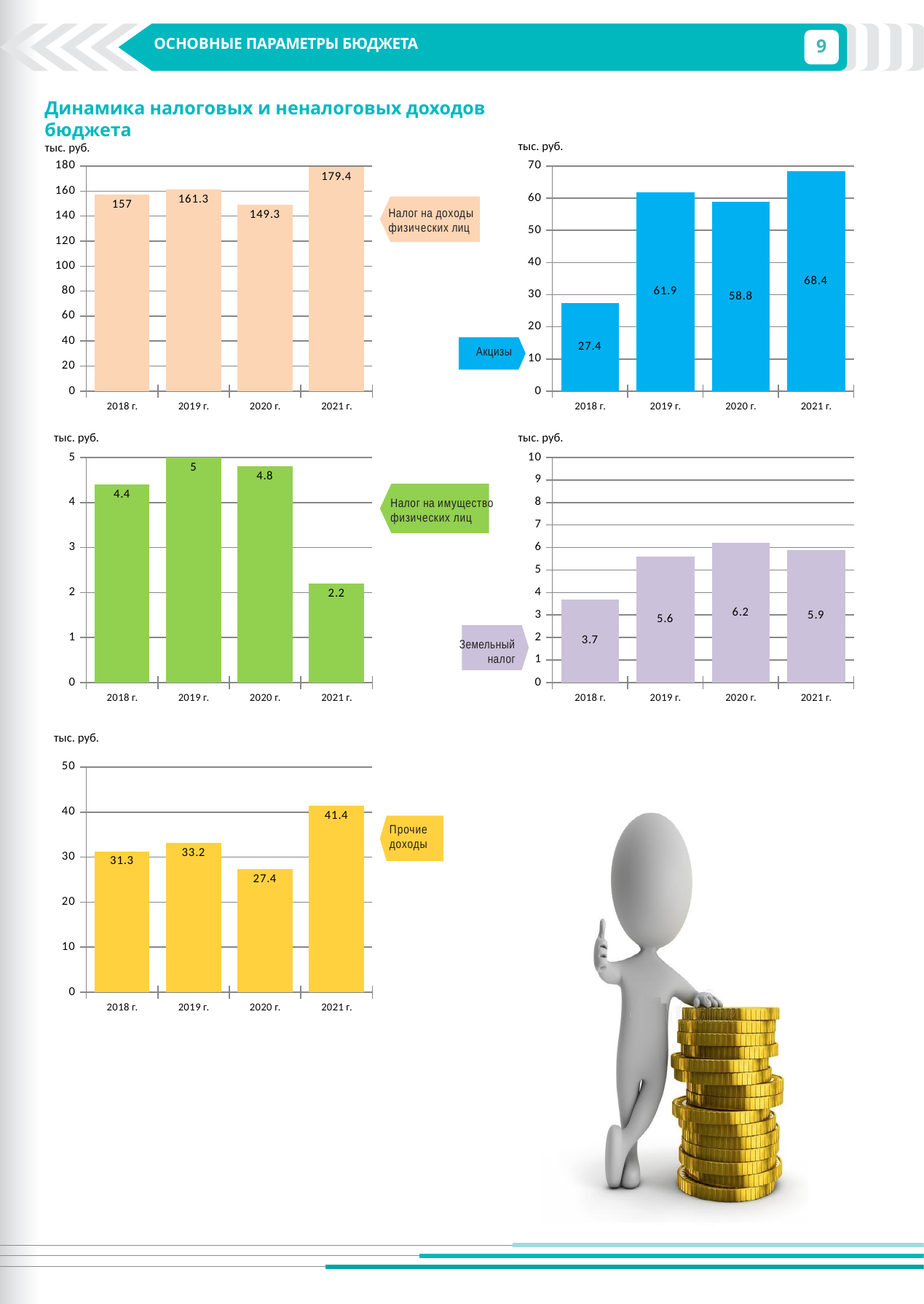
In the 'Земельный налог' chart, what is the value for 2020 г.? 6.2 In the 'Прочие доходы' chart, what is the difference between the values for 2021 г. and 2020 г.? 14 In the 'Акцизы' chart, what is the value for 2018 г.? 27.4 In the 'Акцизы' chart, what is the difference between the values for 2021 г. and 2018 г.? 41 In the 'Налог на доходы физических лиц' chart, which year has the lowest value? 2020 г. In the 'Акцизы' chart, which year has the highest value? 2021 г. In the 'Земельный налог' chart, is the value for 2018 г. greater or less than 4? less In the 'Налог на имущество физических лиц' chart, what is the value for 2021 г.? 2.2 In the 'Налог на имущество физических лиц' chart, which is larger, the value for 2019 г. or 2020 г.? 2019 г. In the 'Налог на доходы физических лиц' chart, what is the value for 2021 г.? 179.4 How many years (categories) are shown in the 'Прочие доходы' chart? 4 What type of chart is the 'Акцизы' chart? Bar chart